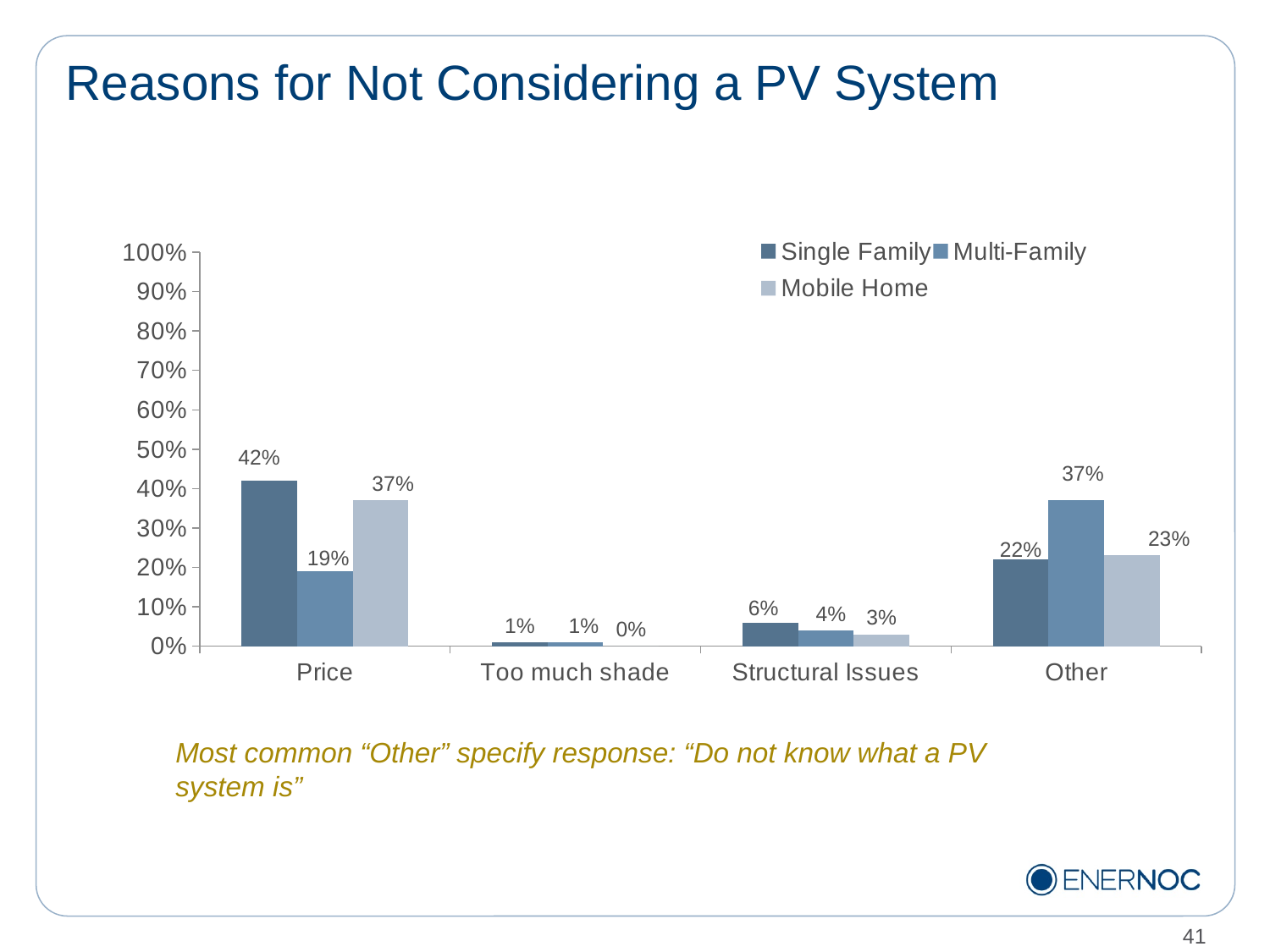
How many series does the legend list? 3 Which is larger in the Other category: Single Family or Multi-Family? Multi-Family What is the value for Single Family in the Price category? 42% Is the value for Mobile Home in the Price category greater or less than 30%? greater What is the title of the chart? Reasons for Not Considering a PV System Which category has the highest value for Single Family? Price What is the difference between the Single Family and Multi-Family values in the Price category? 23% Which category has the lowest value for Mobile Home? Too much shade What is the value for Mobile Home in the Structural Issues category? 3% What is the value for Multi-Family in the Other category? 37% What kind of chart is shown on the slide? Bar chart How many categories are shown on the x axis? 4